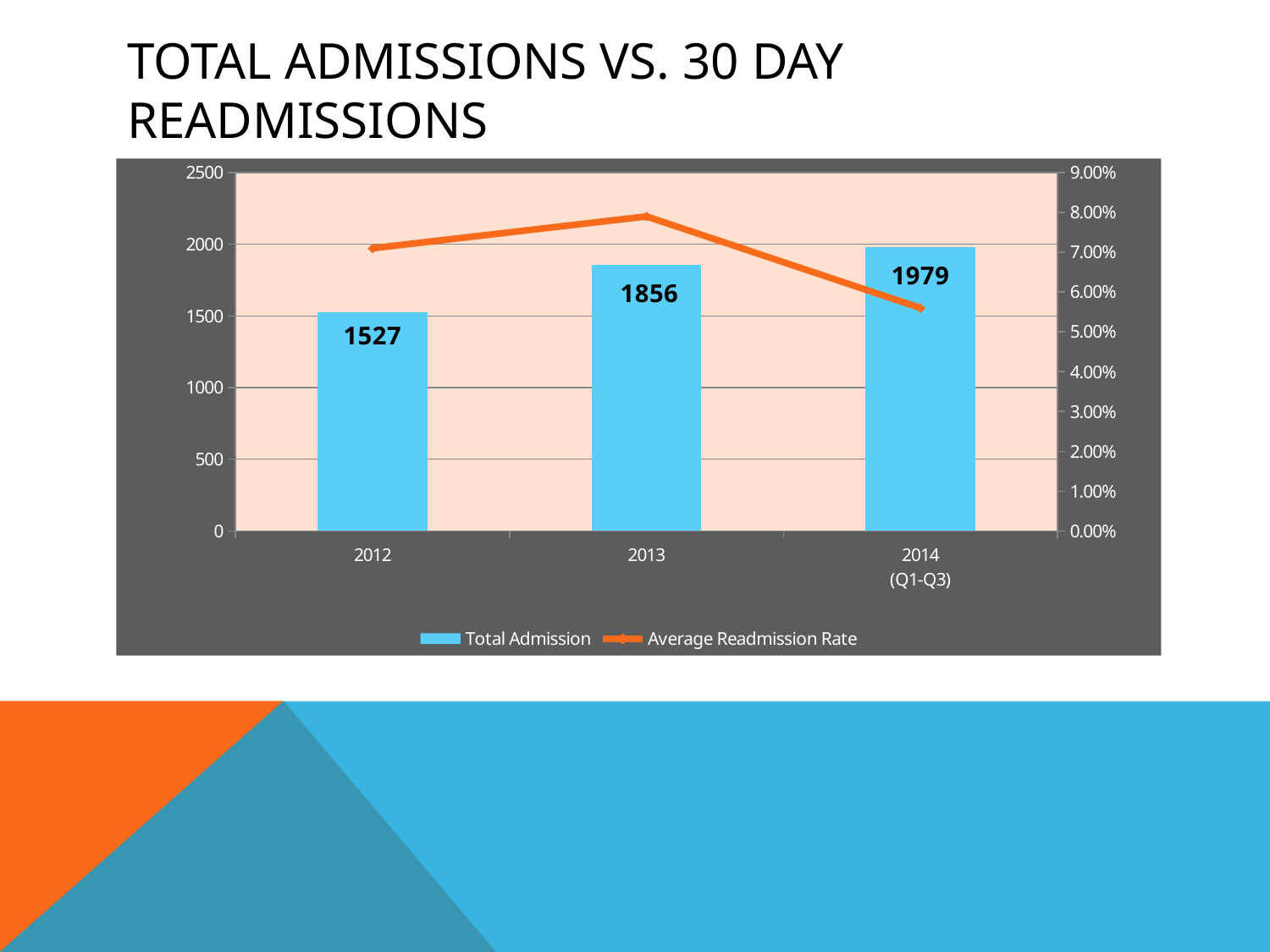
What is the Total Admission value for 2014 (Q1-Q3)? 1979 What is the Total Admission value for 2013? 1856 Is the Average Readmission Rate for 2013 greater or less than 7.00%? greater Which year has the lowest Total Admission? 2012 What is the Total Admission value for 2012? 1527 Which year has the highest Average Readmission Rate? 2013 How many series does the legend list? 2 What is the difference in Total Admission between 2013 and 2012? 329 Is the Average Readmission Rate for 2014 (Q1-Q3) greater or less than 6.00%? less Which year has the highest Total Admission? 2014 (Q1-Q3) Does Total Admission rise or fall from 2012 to 2014 (Q1-Q3)? rise What is the difference in Total Admission between 2014 (Q1-Q3) and 2012? 452